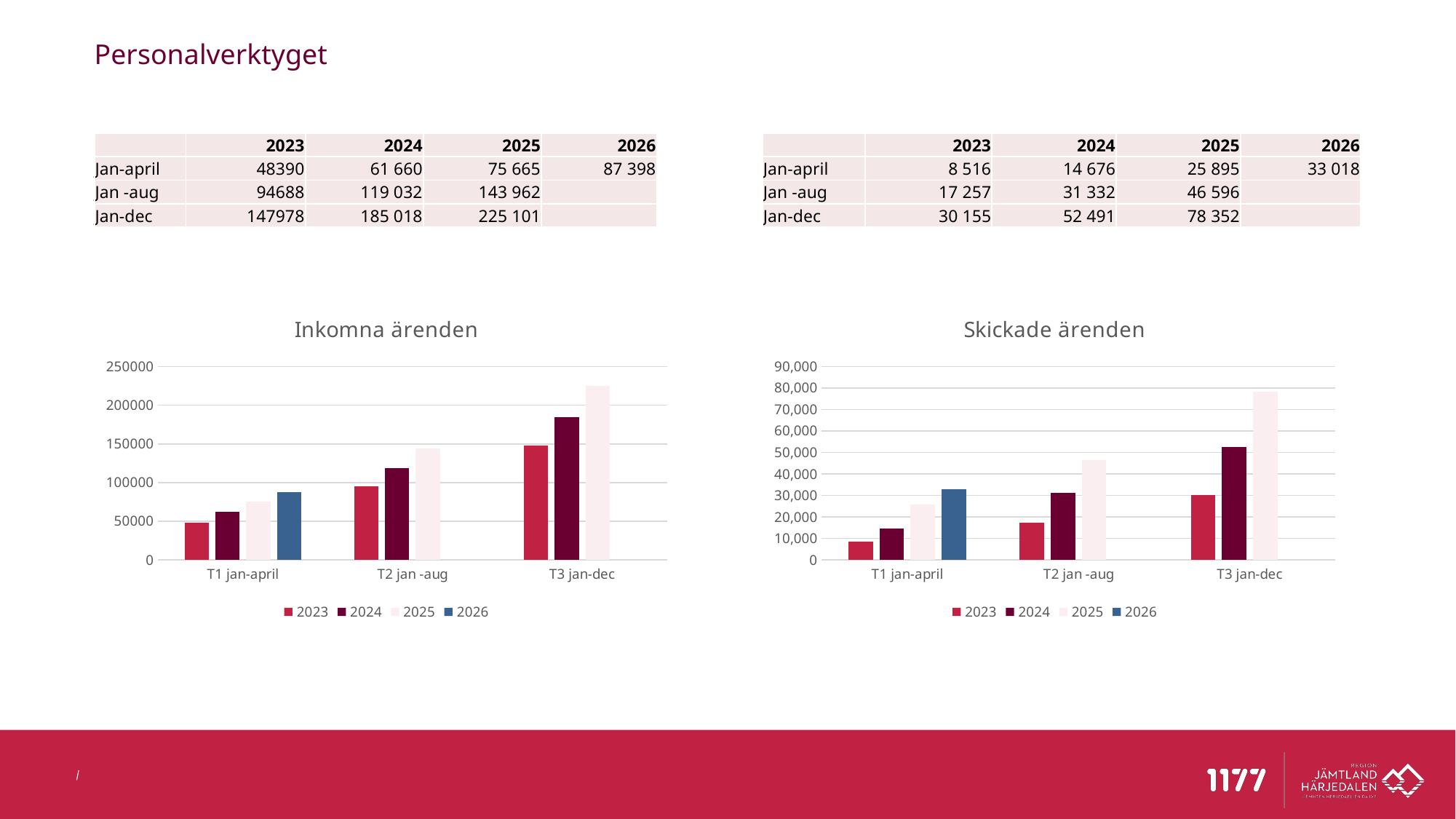
In the Skickade ärenden chart, do the 2025 values rise or fall from T1 jan-april to T3 jan-dec? Rise In the Skickade ärenden chart, which year has the highest bar in T3 jan-dec? 2025 In the Inkomna ärenden chart, what is the difference between the 2026 and 2025 values in T1 jan-april? 11 733 How many series does the legend of the Inkomna ärenden chart list? 4 In the Inkomna ärenden chart, is the value for 2024 in T3 jan-dec greater or less than 150000? greater In the Inkomna ärenden chart, which is larger: 2023 in T2 jan -aug or 2026 in T1 jan-april? 2023 in T2 jan -aug In the Inkomna ärenden chart, what is the value for 2025 in T3 jan-dec? 225 101 What is the title of the chart on the left side of the slide? Inkomna ärenden In the Skickade ärenden chart, which bar is the lowest overall? 2023 in T1 jan-april How many categories are shown on the x axis of the Skickade ärenden chart? 3 What kind of chart is the Skickade ärenden chart? Bar chart In the Skickade ärenden chart, what is the value for 2026 in T1 jan-april? 33 018